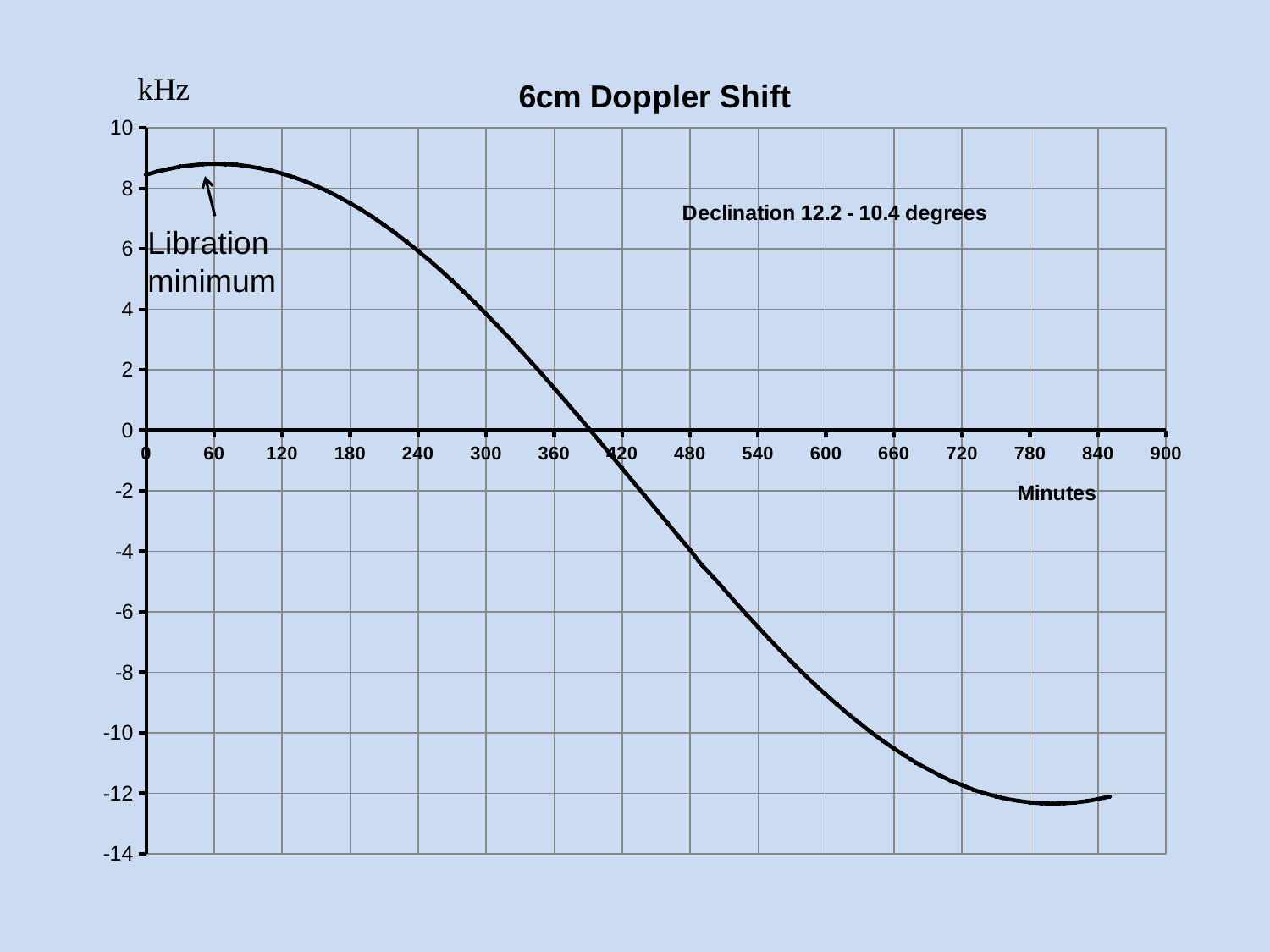
Overall, does the plotted line rise or fall as minutes increase from 0 to 840? fall Is the lowest point of the curve near the start or near the end of the x axis? near the end Is the highest point of the curve near the start or near the end of the x axis? near the start Is the value at 0 minutes greater or less than 8 kHz? greater Which is larger, the value at 120 minutes or the value at 600 minutes? 120 minutes What kind of chart is shown on the slide? line chart What is the title of the chart? 6cm Doppler Shift Is the value at 780 minutes greater or less than -10 kHz? less Is the value at 300 minutes greater or less than 2 kHz? greater What unit is shown on the vertical axis of the chart? kHz